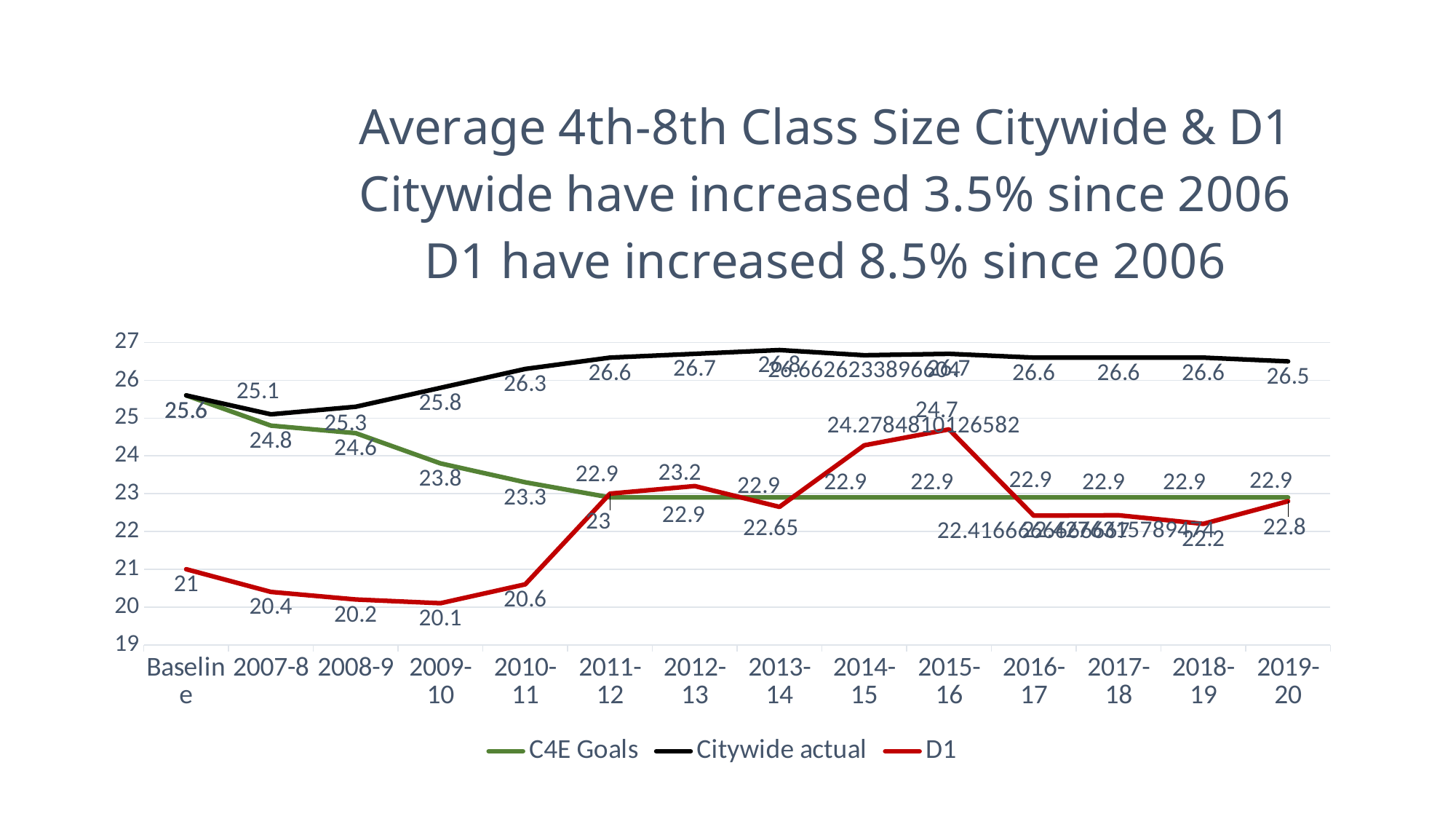
How many points are plotted along the x axis for each series? 14 What is the Citywide actual value for 2012-13? 26.7 Does the D1 line rise or fall from Baseline to 2009-10? fall What kind of chart is shown on the slide? line chart In 2012-13, which is larger: the D1 value or the C4E Goals value? D1 In which year is the D1 value lowest? 2009-10 In which year is the D1 value highest? 2015-16 What is the D1 value for 2009-10? 20.1 What is the difference between the Citywide actual value and the D1 value in 2019-20? 3.7 What is the D1 value for 2019-20? 22.8 How many series does the legend list? 3 What is the C4E Goals value for 2009-10? 23.8